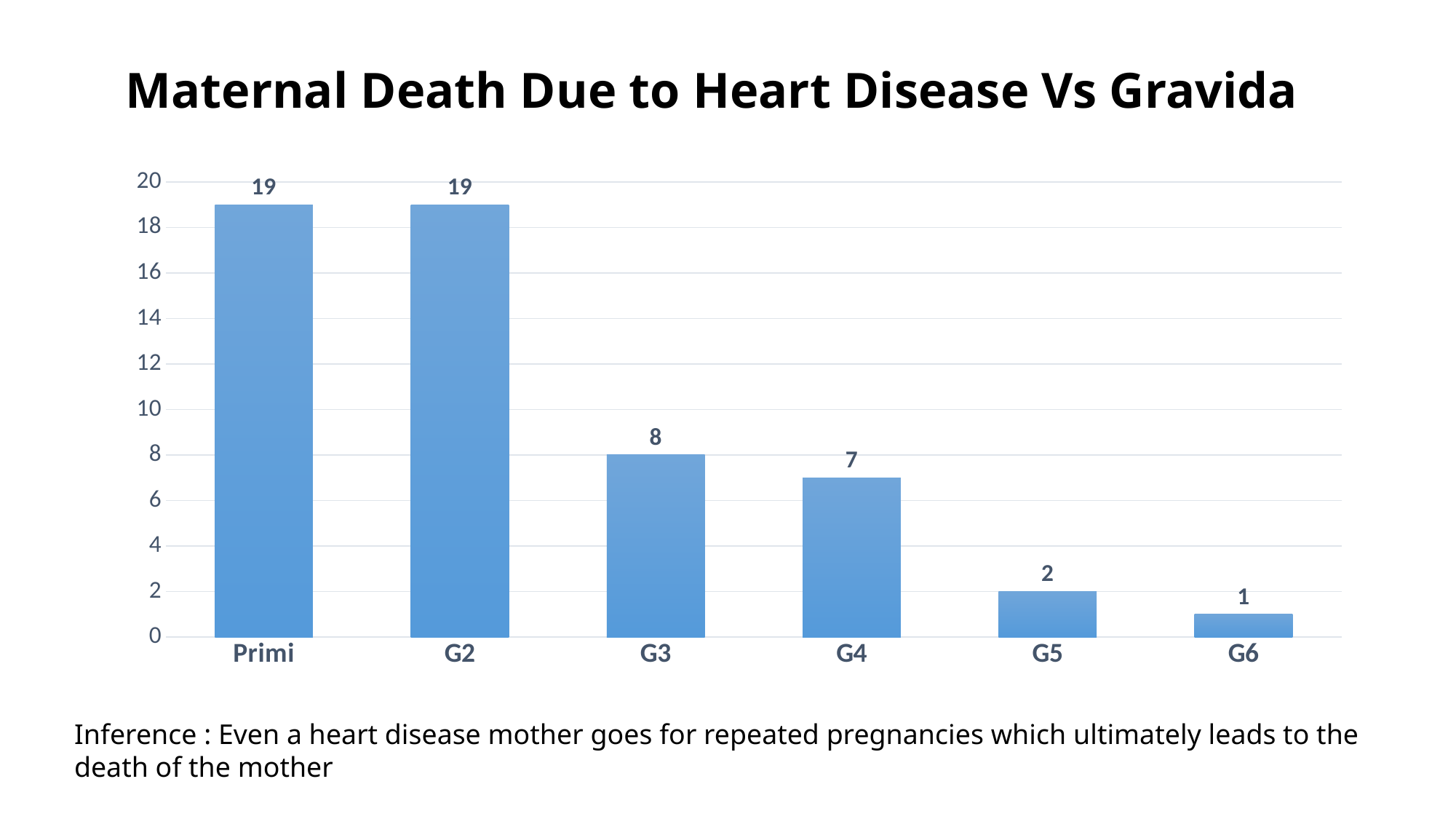
What is the difference between the values for G2 and G4? 12 What is the difference between the values for G3 and G6? 7 How many categories are shown on the x axis? 6 What is the value for G3? 8 Which is larger, the value for G3 or the value for G4? G3 What is the value for G5? 2 What is the title of the chart? Maternal Death Due to Heart Disease Vs Gravida What is the value for Primi? 19 Is the value for G4 greater or less than 10? less Which category has the lowest value? G6 What kind of chart is shown on the slide? bar chart Do the values generally rise or fall from Primi to G6? fall